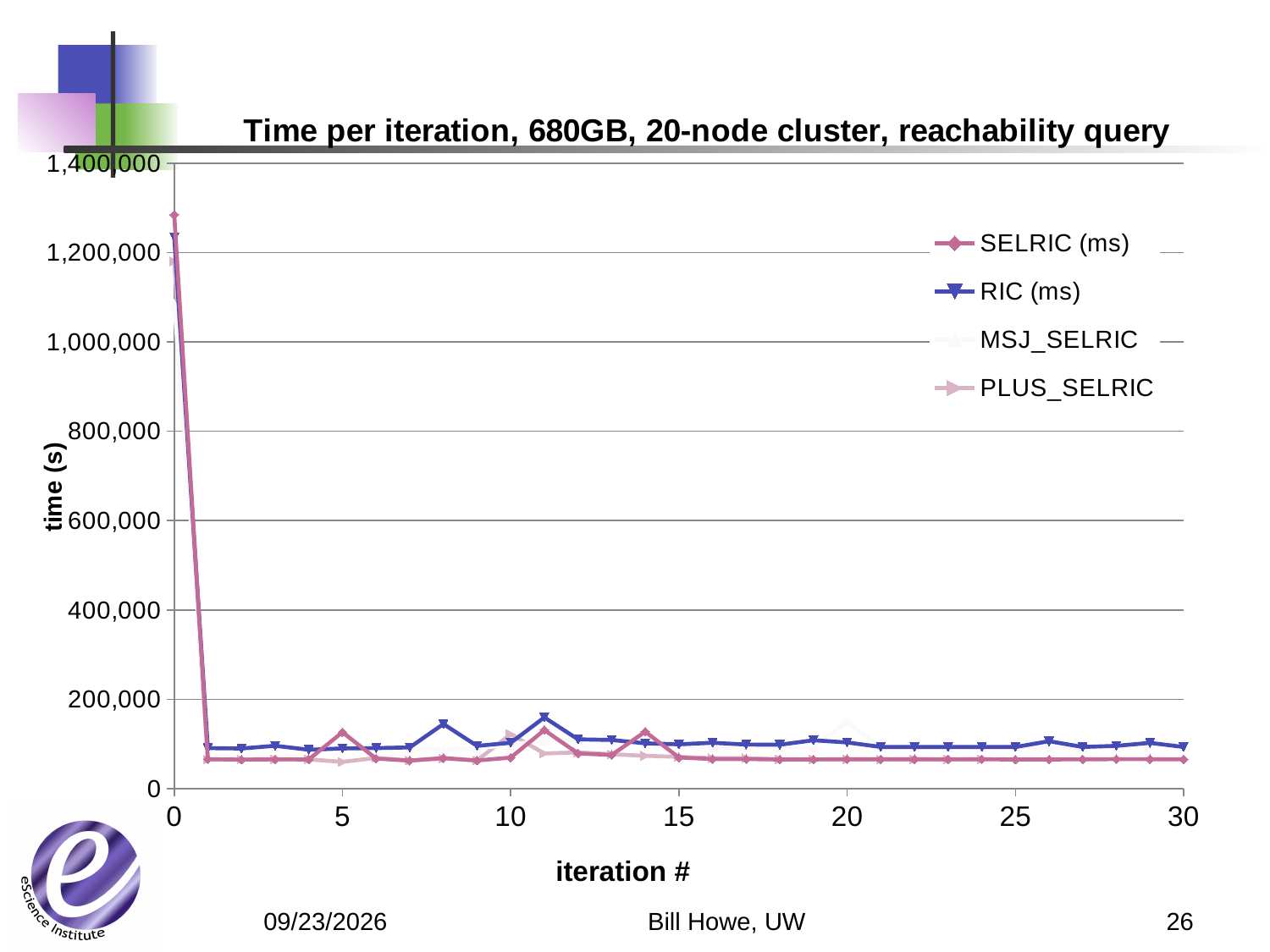
How many series does the legend list? 4 Is the value for SELRIC (ms) at iteration 0 greater or less than 1,200,000? greater At iteration 8, which series has the larger value, RIC (ms) or SELRIC (ms)? RIC (ms) Is the value for SELRIC (ms) at iteration 5 greater or less than 200,000? less What is the label on the y axis? time (s) What kind of chart is shown on the slide? line chart Is the value for RIC (ms) at iteration 8 greater or less than 200,000? less What is the title of the chart? Time per iteration, 680GB, 20-node cluster, reachability query How do the values change from iteration 0 to iteration 1? They fall sharply At which iteration do the series reach their highest values? 0 After iteration 1, do the values generally rise, fall, or stay roughly flat along the x axis? stay roughly flat